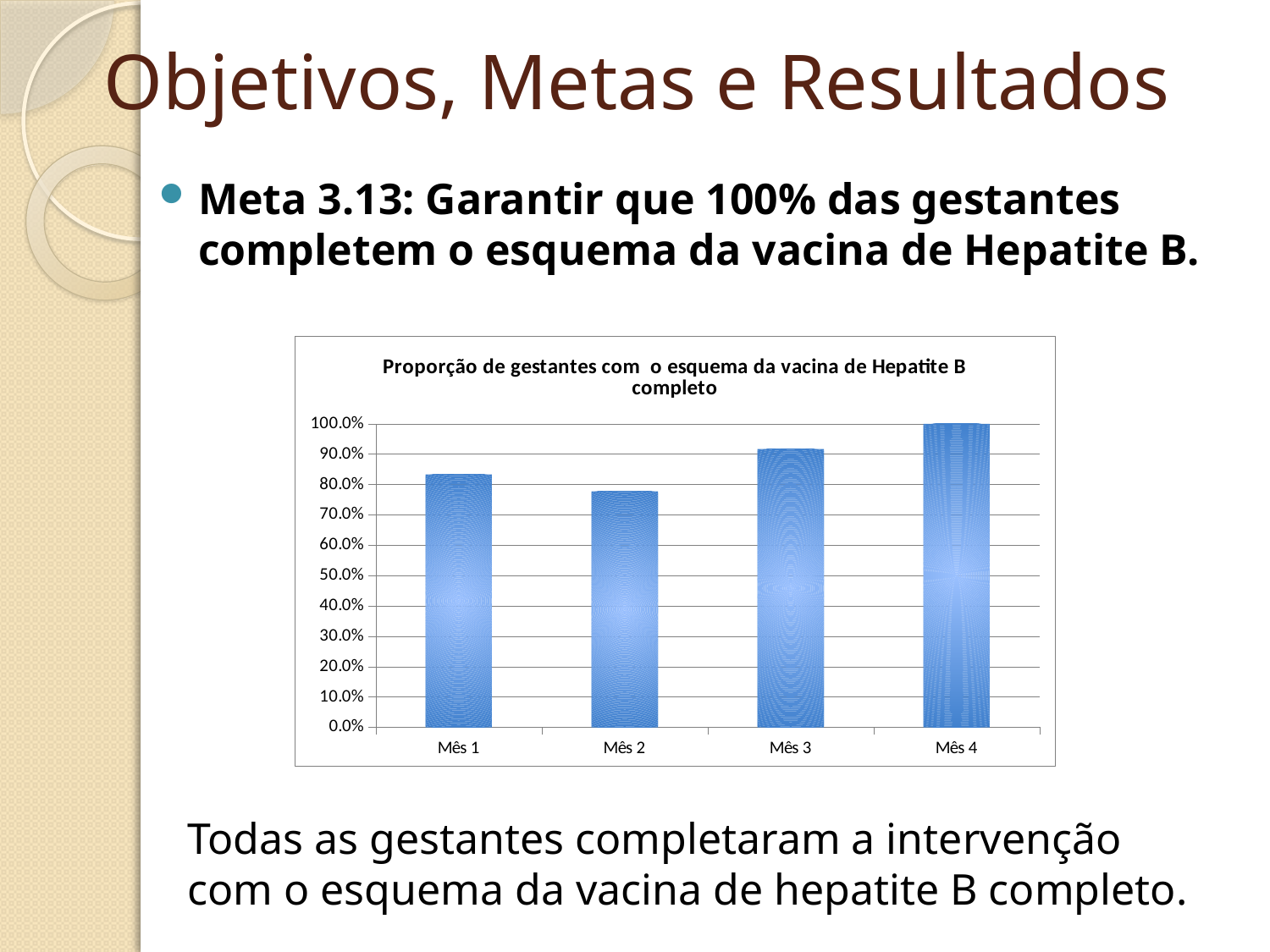
Is the value for Mês 2 greater or less than 80.0%? less What is the highest value shown on the y axis of the chart? 100.0% Which month has the highest proportion of pregnant women with the complete Hepatitis B vaccine scheme? Mês 4 Which is larger, the value for Mês 1 or the value for Mês 2? Mês 1 How many months (categories) are plotted on the x axis of the chart? 4 What is the value for Mês 4 in the chart? 100.0% What is the title of the chart? Proporção de gestantes com o esquema da vacina de Hepatite B completo Is the value for Mês 1 greater or less than 80.0%? greater Which month has the lowest proportion in the chart? Mês 2 What kind of chart is shown on the slide? bar chart Is the value for Mês 3 greater or less than 90.0%? greater Which is larger, the value for Mês 3 or the value for Mês 4? Mês 4